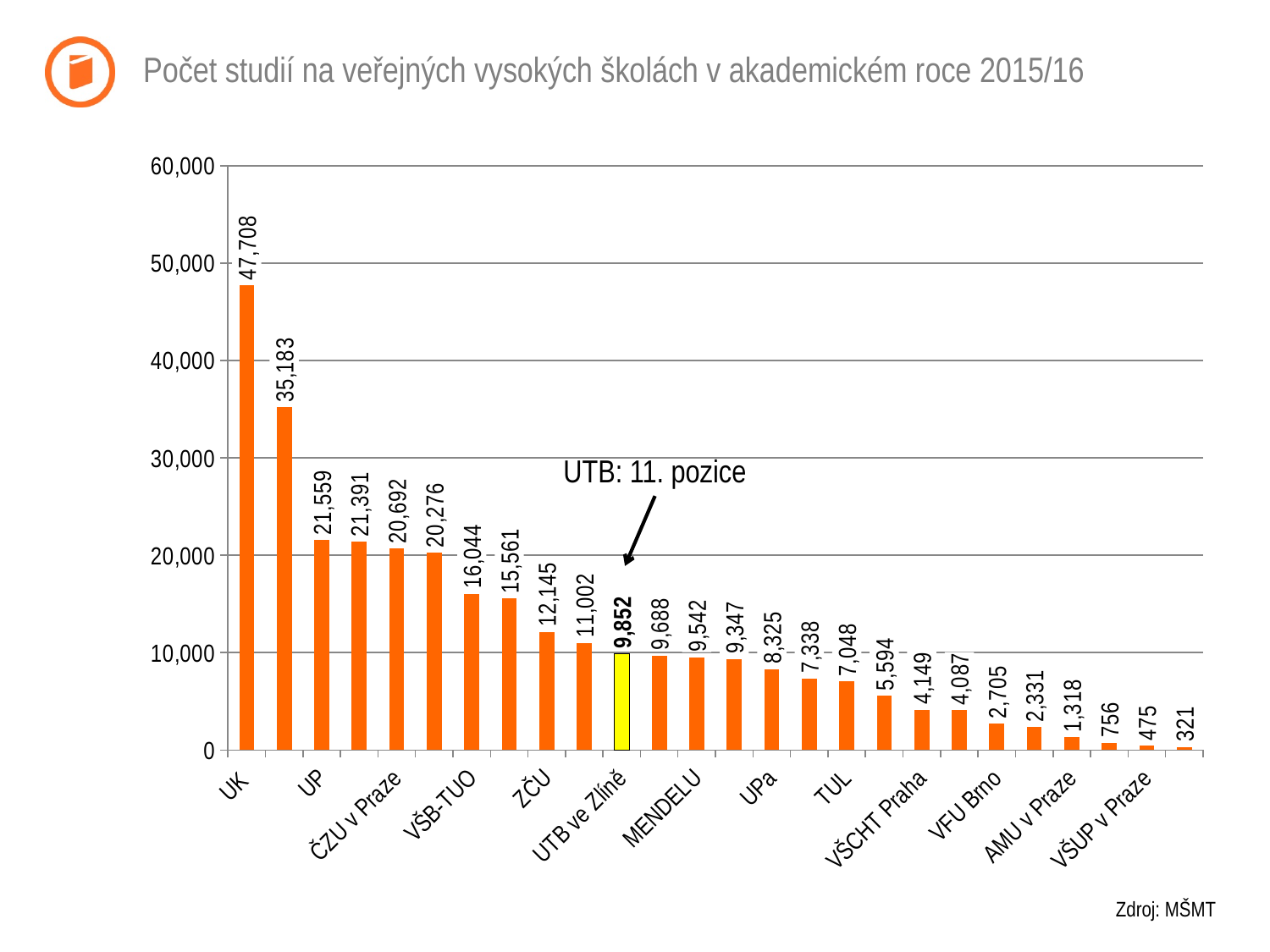
What type of chart is shown on the slide? bar chart What is the value shown for UTB ve Zlíně? 9,852 Which bar is highlighted in yellow? UTB ve Zlíně What is the value shown for ZČU? 12,145 Is the value for VŠB-TUO greater or less than 10,000? greater What is the value shown for TUL? 7,048 What is the smallest value labelled on the chart? 321 Which has a larger value, ZČU or UPa? ZČU What is the difference between the values for UK and UP? 26,149 Do the values rise or fall from left to right along the x axis? fall How many studies does UK have according to the chart? 47,708 Which university has the highest number of studies? UK